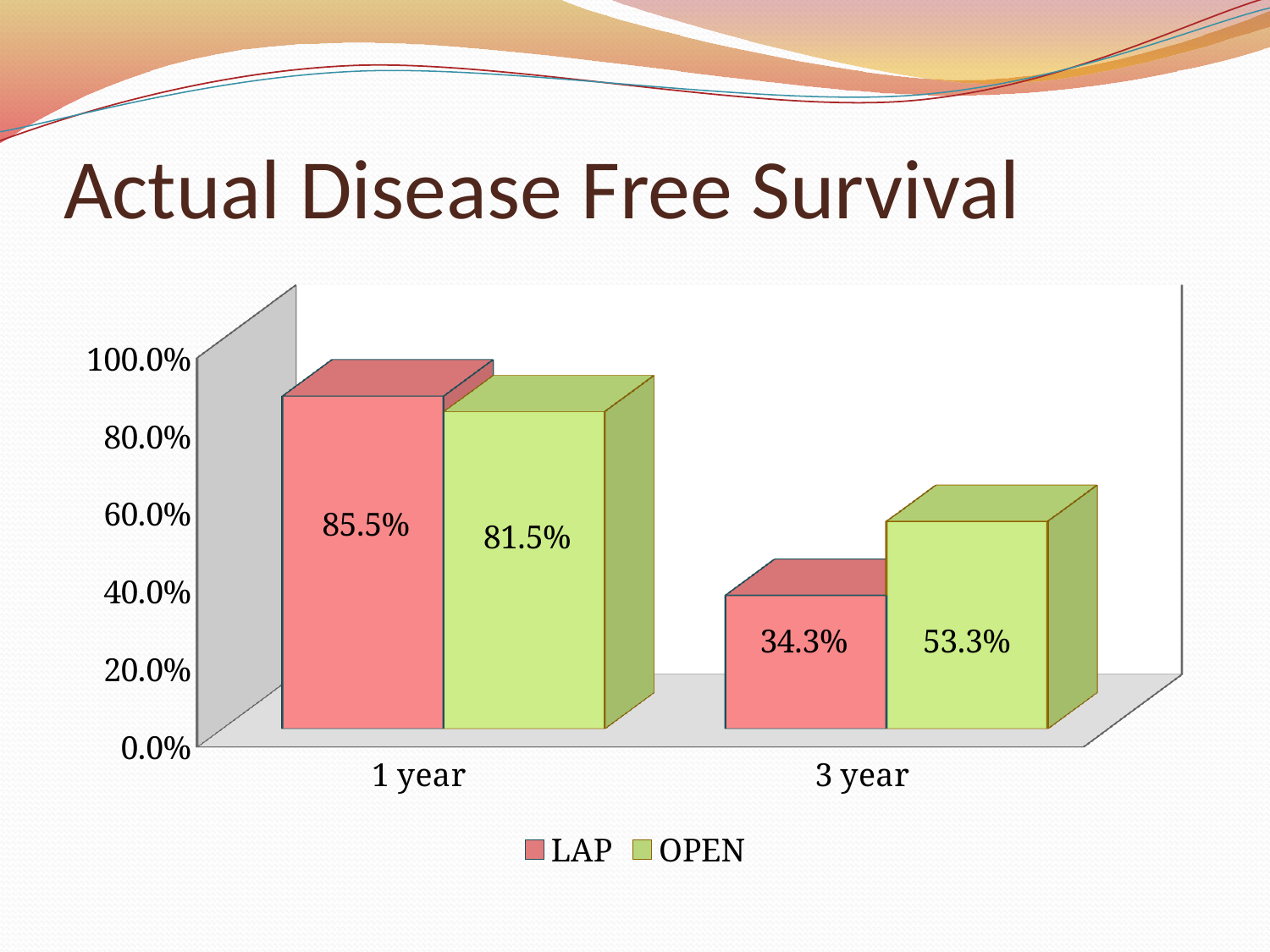
What kind of chart is shown on the slide? Bar chart What is the OPEN value at 3 year? 53.3% What is the LAP value at 3 year? 34.3% What is the OPEN value at 1 year? 81.5% Does the LAP value rise or fall from 1 year to 3 year? Fall Which series has the lowest value at 3 year? LAP Which series has the highest value at 1 year? LAP How many categories are shown on the x axis? 2 How many series does the legend list? 2 Which is larger at 3 year, LAP or OPEN? OPEN What is the difference between the OPEN and LAP values at 3 year? 19.0% What is the LAP value at 1 year? 85.5%